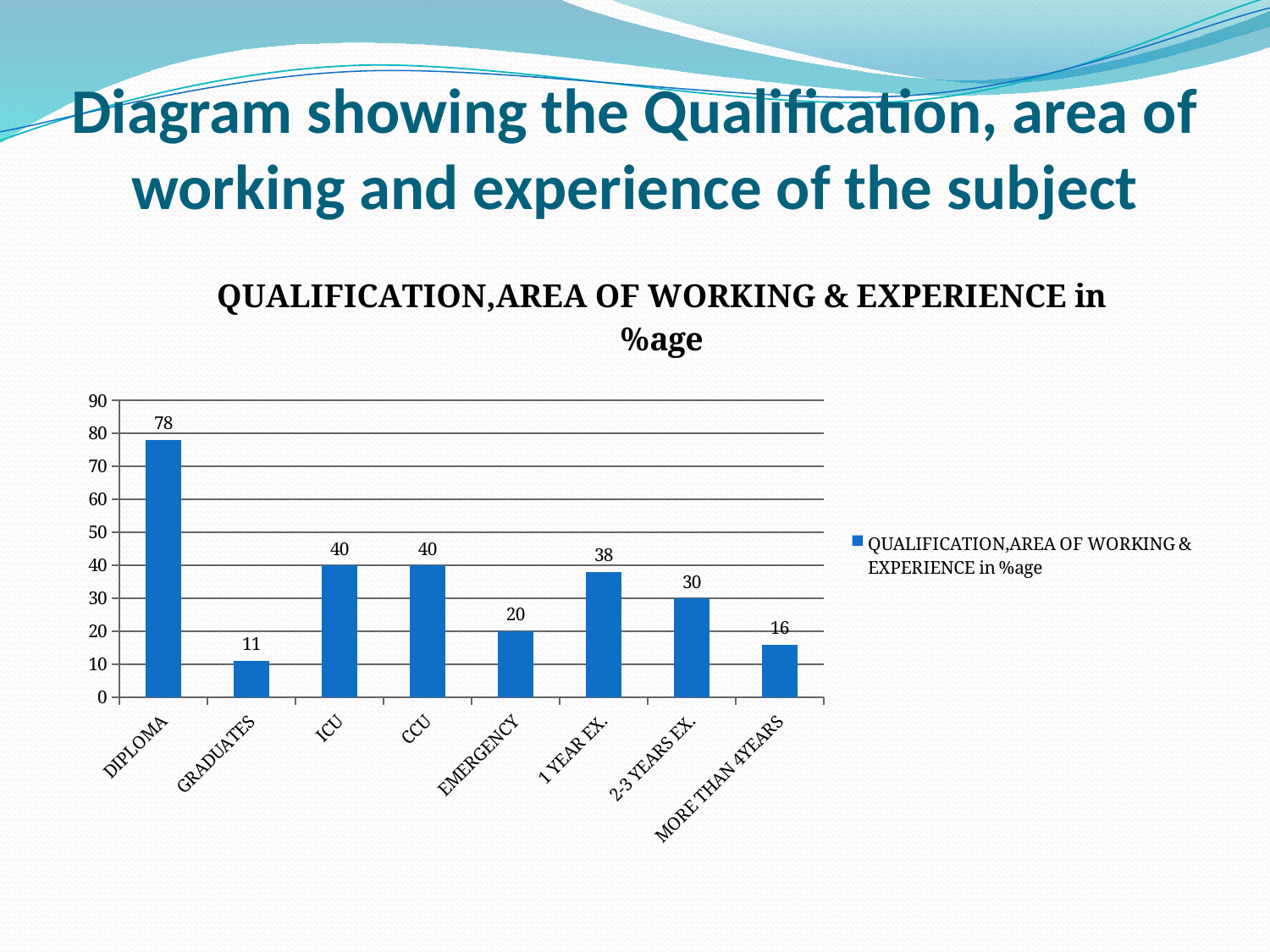
How many series does the legend list? 1 What is the value for 1 YEAR EX.? 38 Which category has the highest value? DIPLOMA How many categories are shown on the x axis? 8 What kind of chart is shown? Bar chart What is the title of the chart? QUALIFICATION,AREA OF WORKING & EXPERIENCE in %age What is the value for DIPLOMA? 78 What is the value for GRADUATES? 11 Which category has the lowest value? GRADUATES What is the difference between the values for DIPLOMA and GRADUATES? 67 What is the value for EMERGENCY? 20 Which is larger, the value for 2-3 YEARS EX. or the value for MORE THAN 4YEARS? 2-3 YEARS EX.